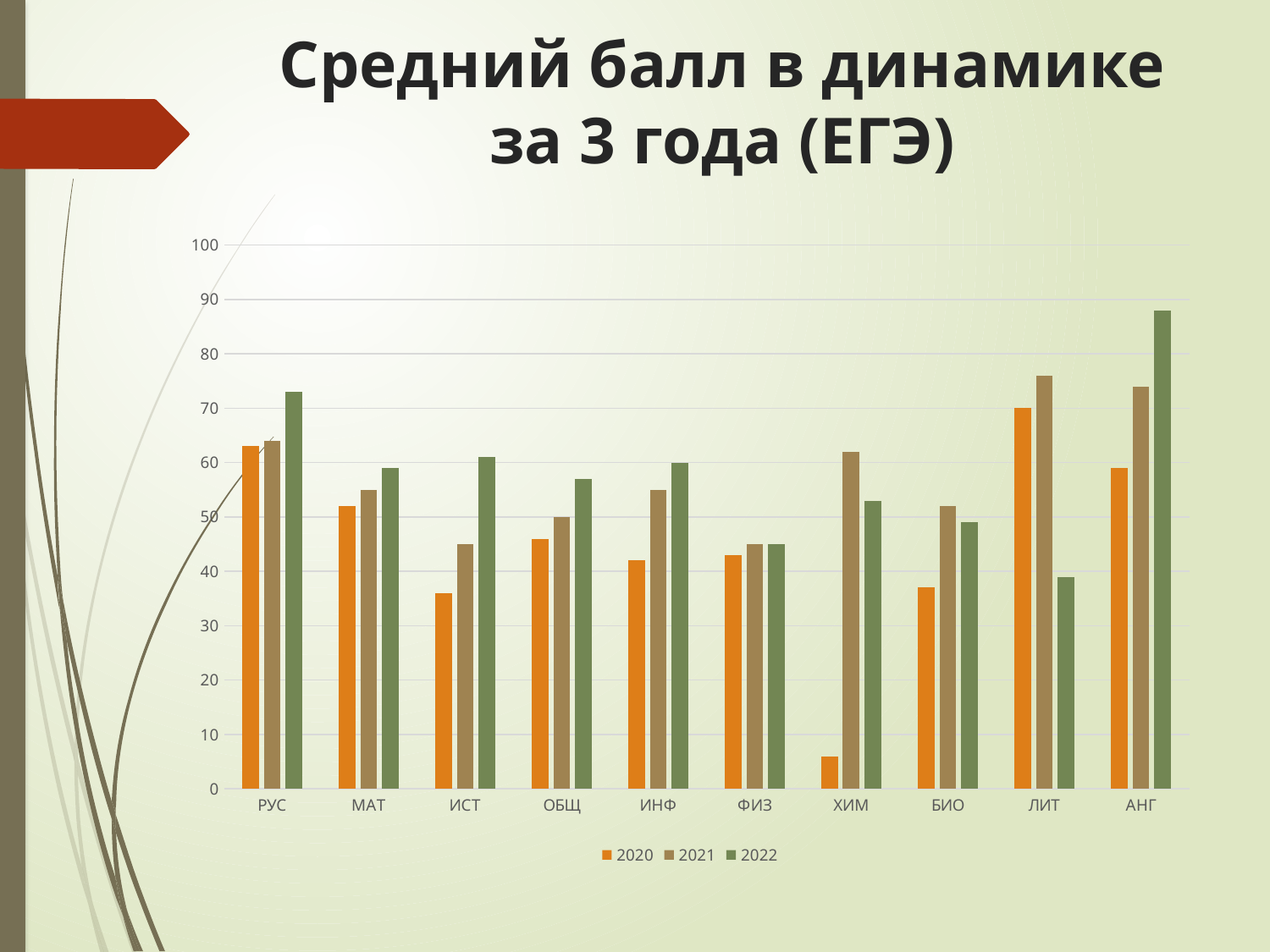
Is the 2020 value for ИСТ greater or less than 40? less How many series does the legend list? 3 Which subject has the highest 2022 bar? АНГ Which subject has the lowest 2020 bar? ХИМ Is the 2022 value for АНГ greater or less than 80? greater For ЛИТ, which is larger: the 2021 value or the 2022 value? 2021 Is the 2021 value for ЛИТ greater or less than 70? greater For РУС, do the values rise or fall from 2020 to 2022? rise How many subject categories are shown on the x axis? 10 Which series are listed in the legend? 2020, 2021, 2022 What kind of chart is shown on the slide? bar chart